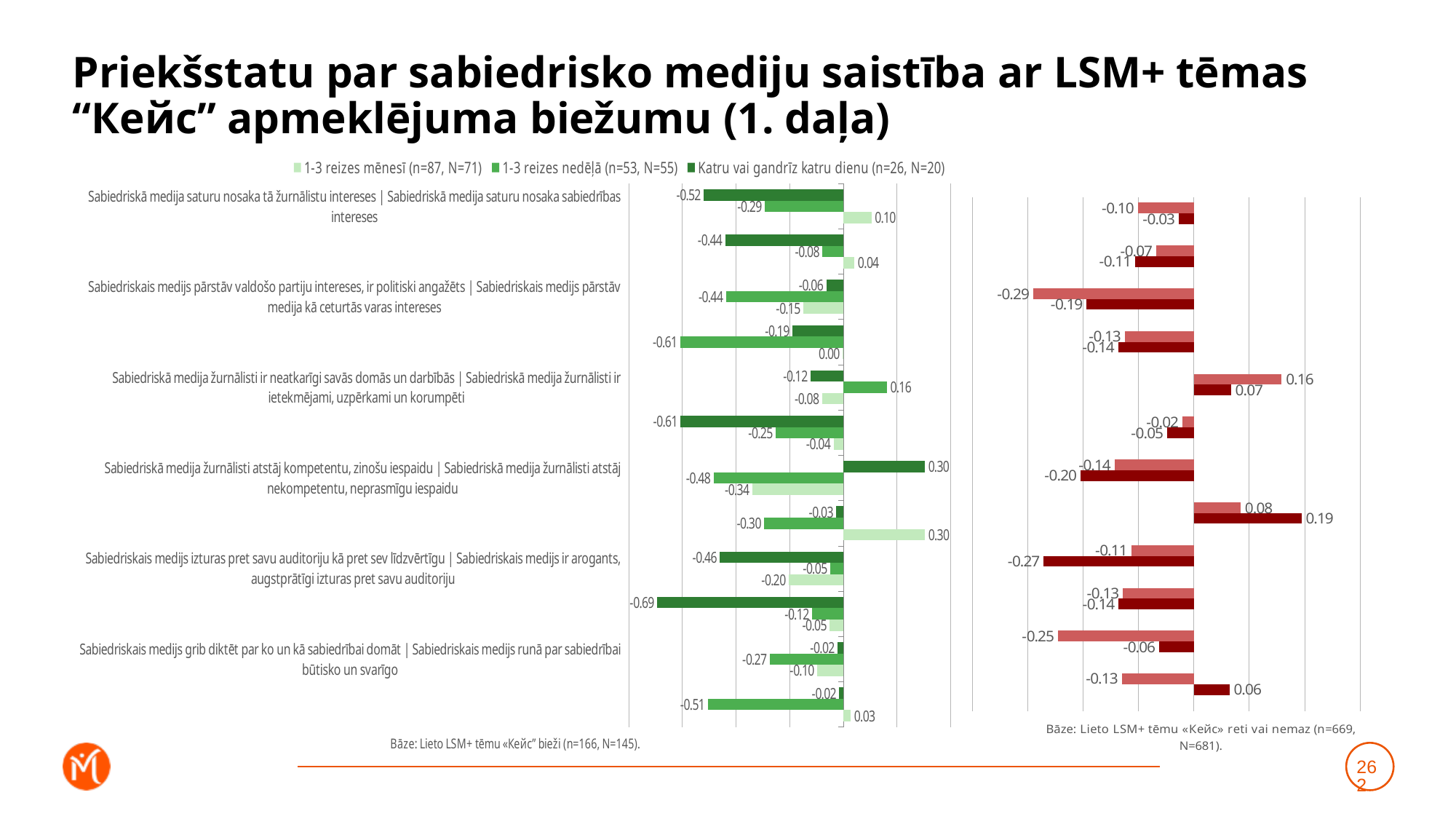
What base (Bāze) text is shown under the left (green) chart? Bāze: Lieto LSM+ tēmu «Кейс» bieži (n=166, N=145). In the right (red) chart, is the lowest value greater or less than -0.20? less In the right (red) chart, what is the lowest value shown by any bar? -0.29 What is the difference between the highest value (0.30) and the lowest value (-0.69) in the left (green) chart? 0.99 In the left (green) chart, what is the first legend entry? 1-3 reizes mēnesī (n=87, N=71) In the left (green) chart, how many series does the legend list? 3 What kind of chart is used on this slide? Bar chart Which is larger: the highest value in the left (green) chart or the highest value in the right (red) chart? The left (green) chart, 0.30 How many groups of bars are plotted in the right (red) chart? 12 In the left (green) chart, what is the highest value shown by any bar? 0.30 In the right (red) chart, what is the highest value shown by any bar? 0.19 In the left (green) chart, what is the lowest value shown by any bar? -0.69